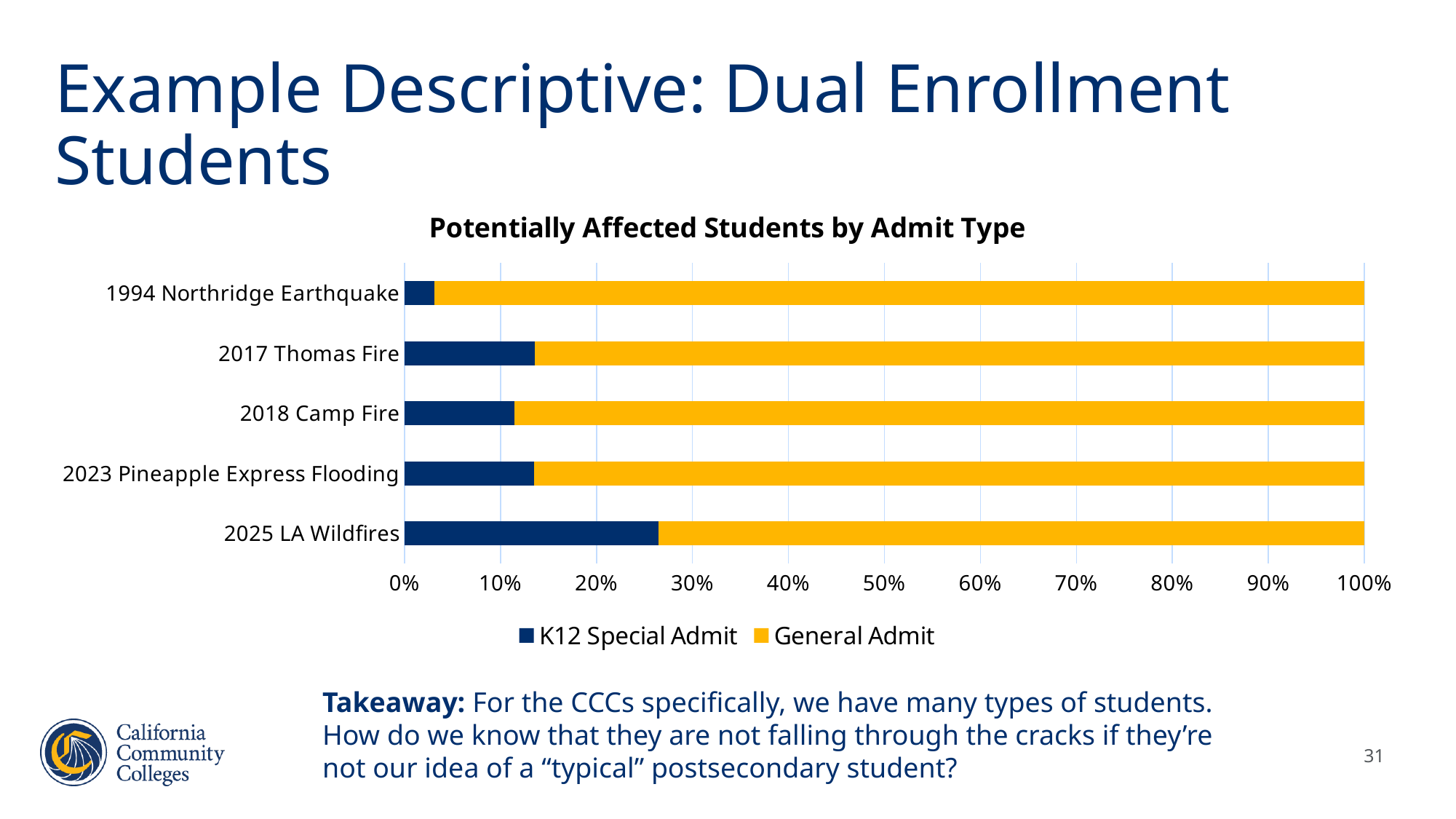
What is the total of the stacked bar for 2017 Thomas Fire? 100% How many disaster events (categories) are shown on the chart? 5 How many series does the legend list? 2 What kind of chart is shown on the slide? Stacked bar chart Which event has the lowest share of K12 Special Admit students? 1994 Northridge Earthquake Which has a larger K12 Special Admit share: 2025 LA Wildfires or 2018 Camp Fire? 2025 LA Wildfires Which event has the highest share of K12 Special Admit students? 2025 LA Wildfires Is the General Admit share for 2017 Thomas Fire greater or less than 80%? greater Is the K12 Special Admit share for 2025 LA Wildfires greater or less than 20%? greater Which series is shown in dark blue in the legend? K12 Special Admit What is the title of the chart? Potentially Affected Students by Admit Type Is the K12 Special Admit share for 1994 Northridge Earthquake greater or less than 10%? less